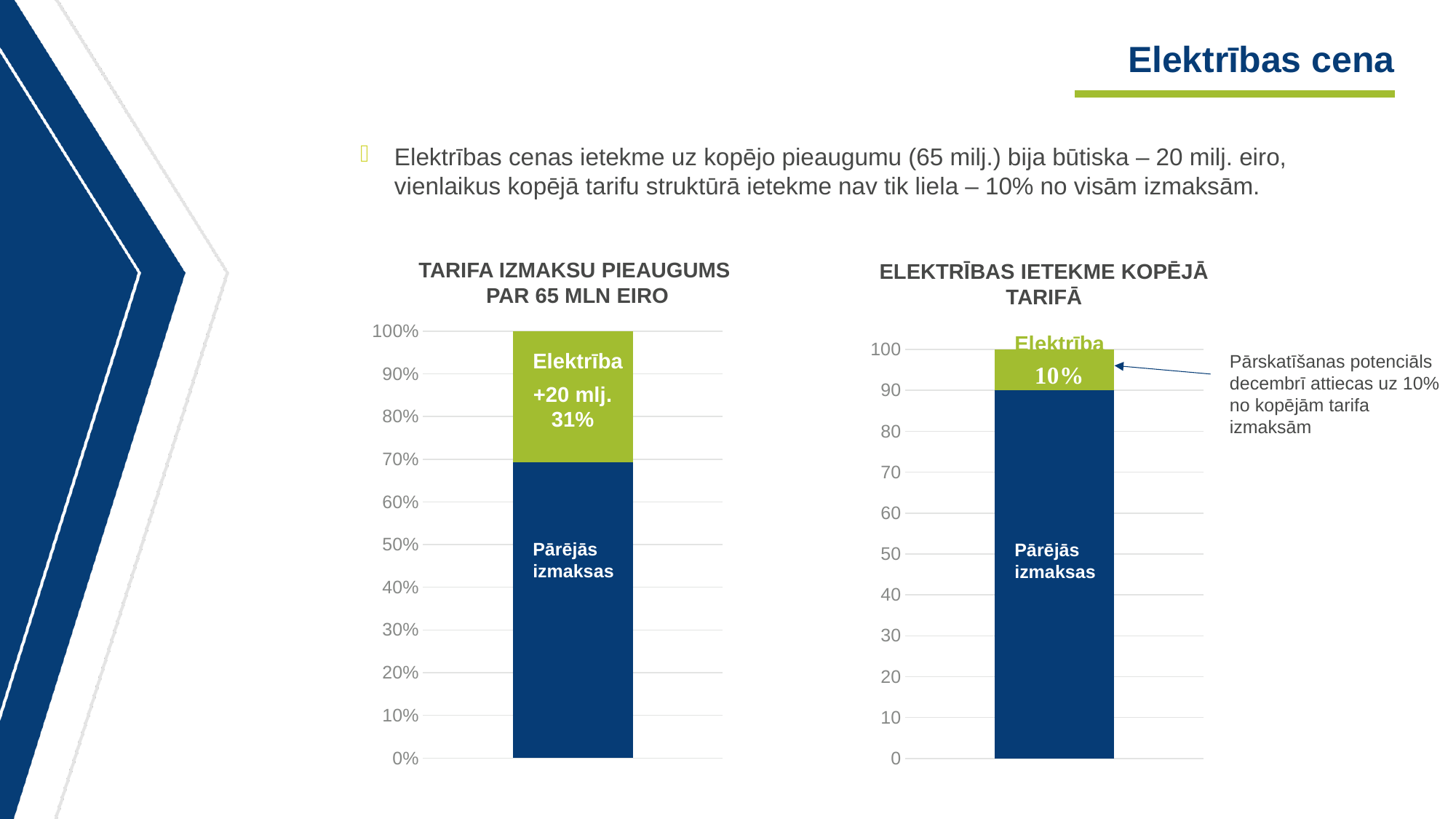
In the left chart 'TARIFA IZMAKSU PIEAUGUMS PAR 65 MLN EIRO', is the Pārējās izmaksas segment greater or less than 60%? greater What kind of chart is the left chart titled 'TARIFA IZMAKSU PIEAUGUMS PAR 65 MLN EIRO'? Stacked bar chart What is the title of the right chart? ELEKTRĪBAS IETEKME KOPĒJĀ TARIFĀ In the right chart 'ELEKTRĪBAS IETEKME KOPĒJĀ TARIFĀ', which segment is smaller, Elektrība or Pārējās izmaksas? Elektrība How many segments make up the stacked bar in the right chart 'ELEKTRĪBAS IETEKME KOPĒJĀ TARIFĀ'? 2 In the left chart 'TARIFA IZMAKSU PIEAUGUMS PAR 65 MLN EIRO', what colour is the Elektrība segment? Green In the left chart 'TARIFA IZMAKSU PIEAUGUMS PAR 65 MLN EIRO', which segment is larger, Elektrība or Pārējās izmaksas? Pārējās izmaksas In the left chart 'TARIFA IZMAKSU PIEAUGUMS PAR 65 MLN EIRO', what percentage is shown for the Elektrība segment? 31% In the right chart 'ELEKTRĪBAS IETEKME KOPĒJĀ TARIFĀ', is the Pārējās izmaksas segment greater or less than 80? greater In the right chart 'ELEKTRĪBAS IETEKME KOPĒJĀ TARIFĀ', what is the highest value shown on the vertical axis? 100 In the left chart 'TARIFA IZMAKSU PIEAUGUMS PAR 65 MLN EIRO', what amount in mlj. is labelled on the Elektrība segment? +20 mlj. In the right chart 'ELEKTRĪBAS IETEKME KOPĒJĀ TARIFĀ', what value is shown for Elektrība? 10%